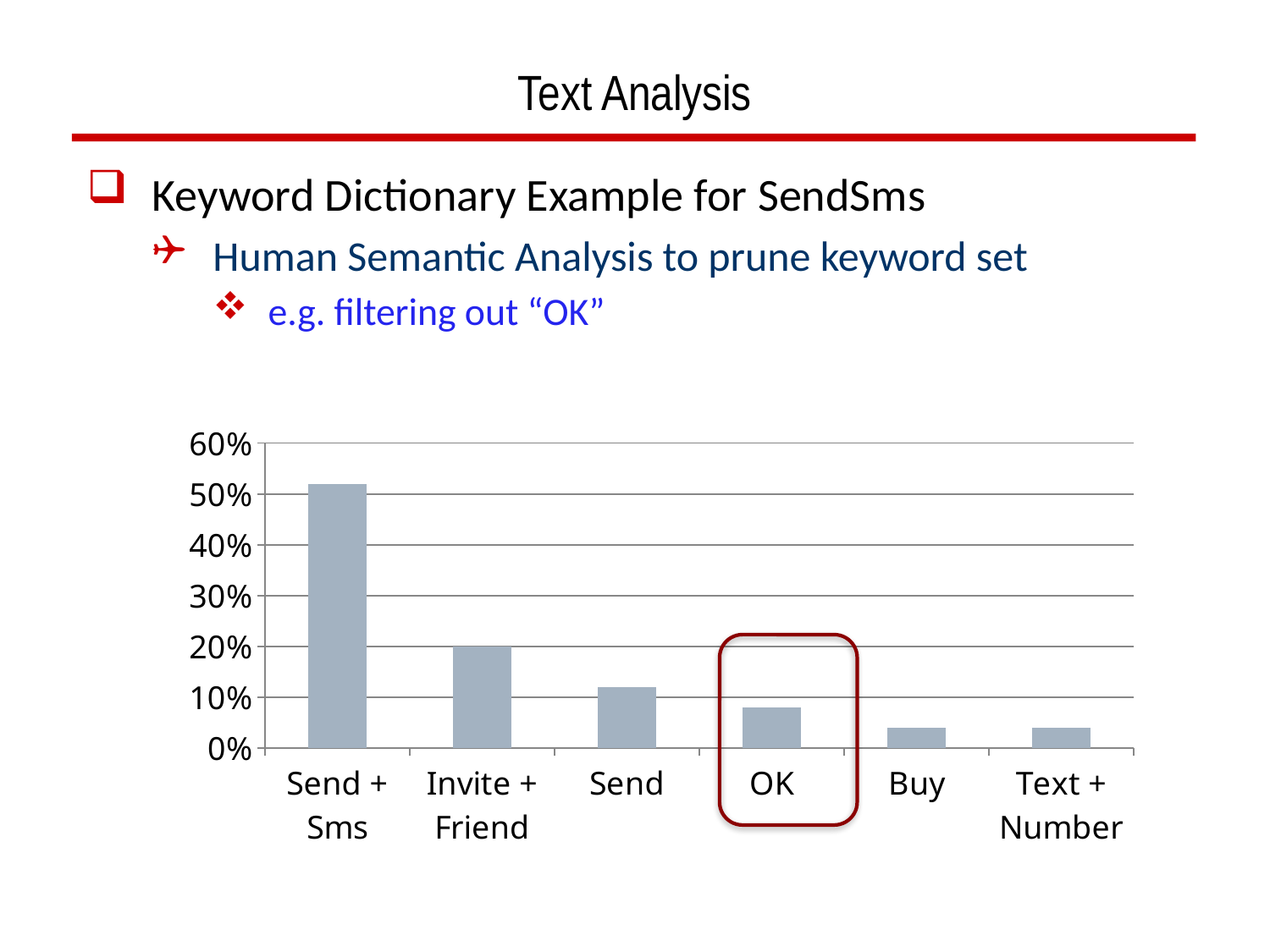
What kind of chart is shown on the slide? bar chart Is the value for Send + Sms greater or less than 50%? greater How many categories are shown on the x axis of the chart? 6 Is the value for Send greater or less than 10%? greater Do the values rise or fall from left to right along the x axis? fall Which category has the highest value in the chart? Send + Sms Is the value for OK greater or less than 10%? less What is the value for Invite + Friend? 20% Which is larger, the value for Invite + Friend or the value for Send + Sms? Send + Sms Which is larger, the value for Send or the value for OK? Send Which category on the chart is highlighted with a red outline? OK